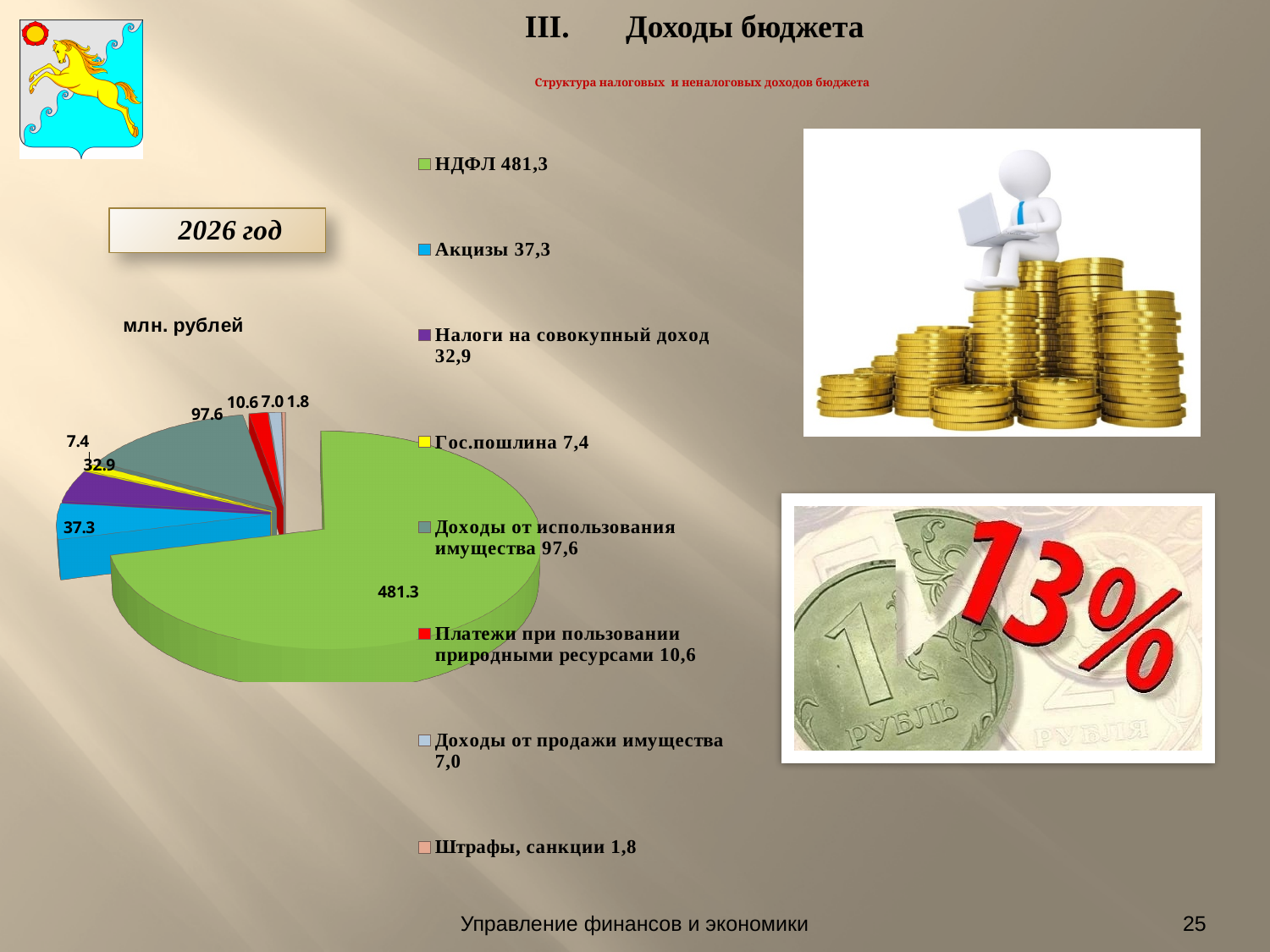
Which category has the largest slice in the pie chart? НДФЛ What is the value for Штрафы, санкции in the pie chart? 1.8 What type of chart is shown on the slide? Pie chart Which category has the smallest slice in the pie chart? Штрафы, санкции What is the value for НДФЛ in the pie chart? 481.3 What is the difference between the values for Акцизы and Налоги на совокупный доход? 4.4 What is the difference between the values for НДФЛ and Доходы от использования имущества? 383.7 What is the value for Доходы от использования имущества in the pie chart? 97.6 In what units are the values of the pie chart given? млн. рублей What is the value for Акцизы in the pie chart? 37.3 Which is larger in the pie chart: Акцизы or Налоги на совокупный доход? Акцизы How many categories does the pie chart show? 8